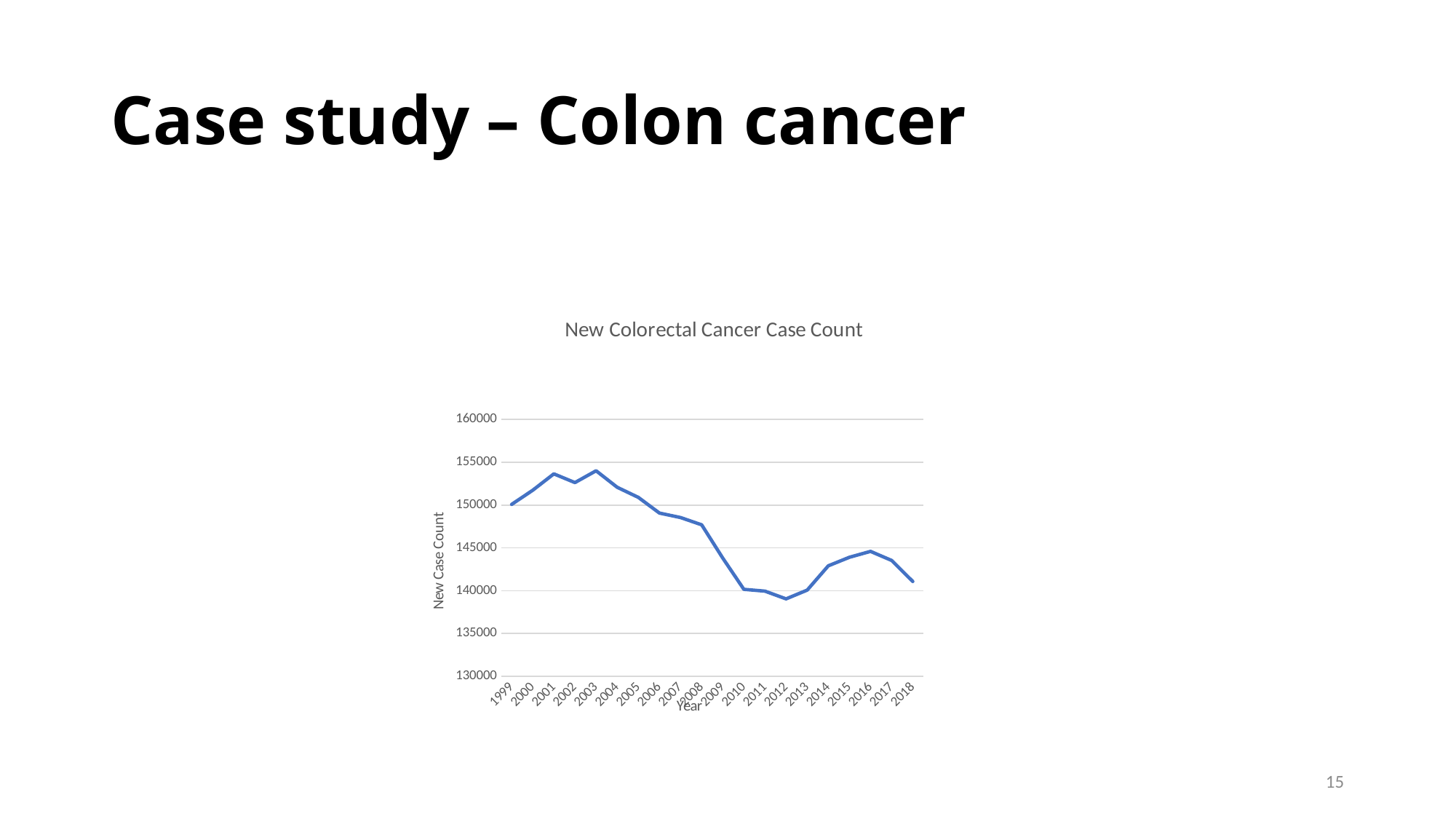
How many years are plotted on the x axis of the chart? 20 Is the value for 2018 greater or less than 145000? less Which year has the lowest new case count? 2012 Is the value for 2012 greater or less than 140000? less Is the value for 2003 greater or less than 150000? greater Overall, do the new case counts rise or fall from 1999 to 2018? fall Which year has the higher new case count, 1999 or 2018? 1999 What is the title of the chart? New Colorectal Cancer Case Count What is the label on the vertical axis of the chart? New Case Count Which year has the higher new case count, 2003 or 2012? 2003 What kind of chart is shown on the slide? line chart